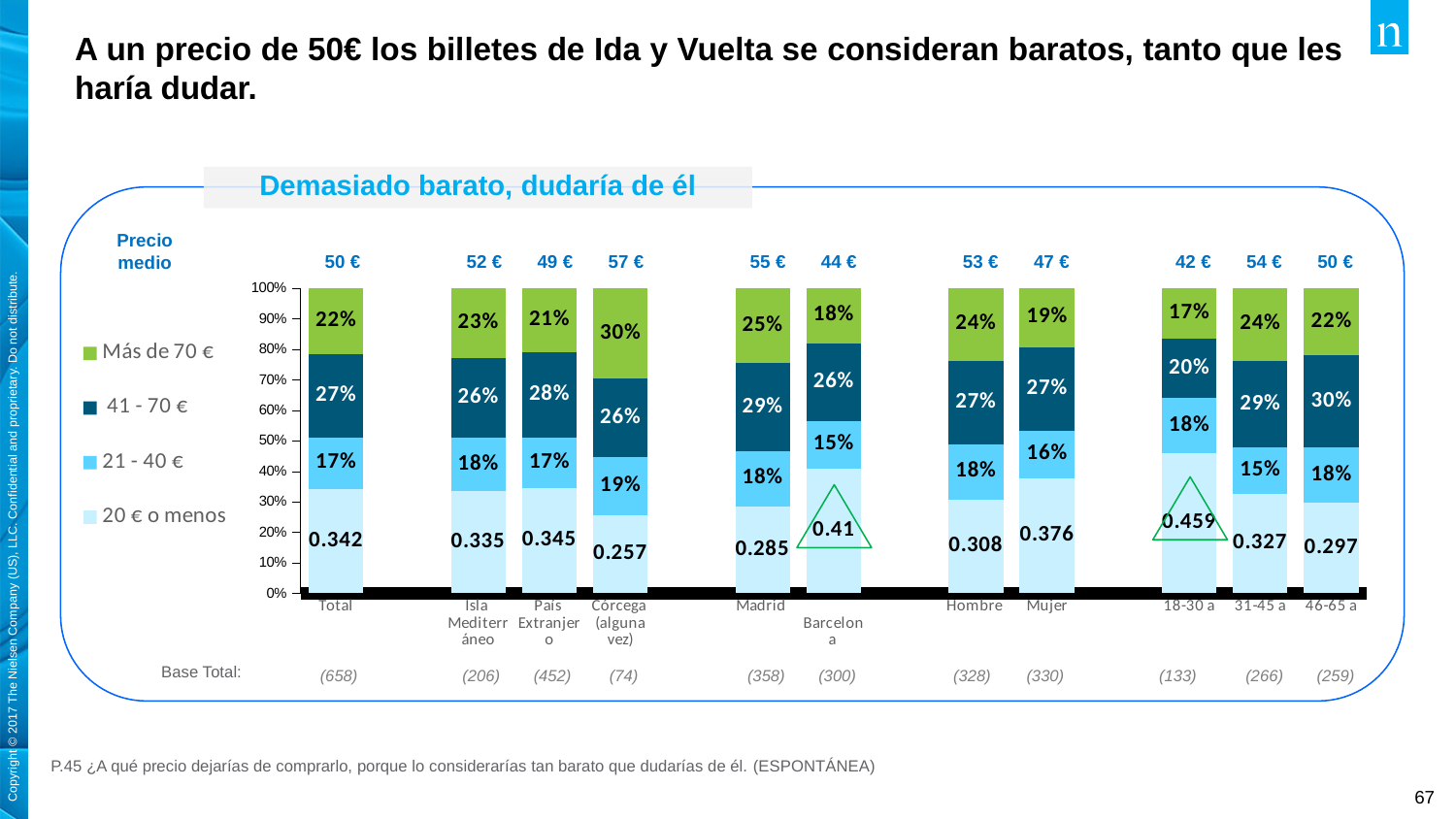
What is the value of the '21 - 40 €' segment for Mujer? 16% Which category has the highest 'Más de 70 €' share? Córcega (alguna vez) What kind of chart is shown on the slide? Stacked bar chart Which category has the lowest 'Más de 70 €' share? 18-30 a Which has a larger '41 - 70 €' share, Córcega (alguna vez) or 46-65 a? 46-65 a What is the value of the '20 € o menos' segment for 18-30 a? 0.459 What is the value of the '41 - 70 €' segment for Barcelona? 26% What is the value of the 'Más de 70 €' segment for Córcega (alguna vez)? 30% How many categories are plotted along the x axis? 11 What is the difference between the 'Más de 70 €' share for Córcega (alguna vez) and for Barcelona? 12 percentage points What 'Precio medio' is shown above the Barcelona bar? 44 € How many series does the legend list? 4